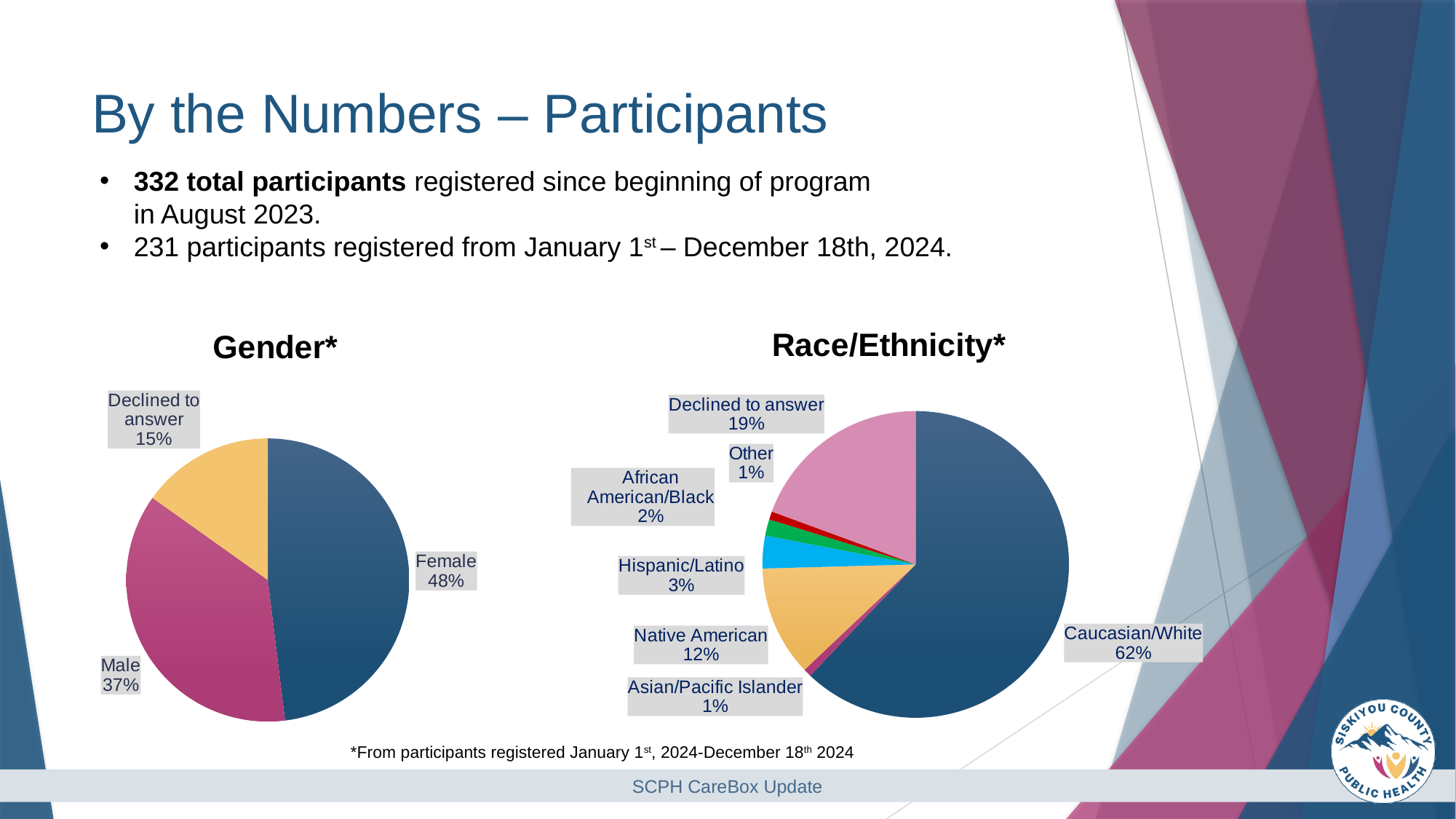
In the Gender* chart, what percentage of participants are Female? 48% How many categories does the Gender* chart show? 3 In the Gender* chart, what percentage of participants are Male? 37% In the Race/Ethnicity* chart, which is larger, Hispanic/Latino or African American/Black? Hispanic/Latino In the Race/Ethnicity* chart, what percentage of participants are Caucasian/White? 62% In the Gender* chart, which category has the smallest share? Declined to answer What kind of chart is the Race/Ethnicity* chart? Pie chart In the Race/Ethnicity* chart, what percentage of participants are Native American? 12% How many categories does the Race/Ethnicity* chart show? 7 In the Race/Ethnicity* chart, which category has the largest share? Caucasian/White In the Gender* chart, what is the difference in percentage points between Female and Male? 11 In the Race/Ethnicity* chart, what percentage of participants declined to answer? 19%